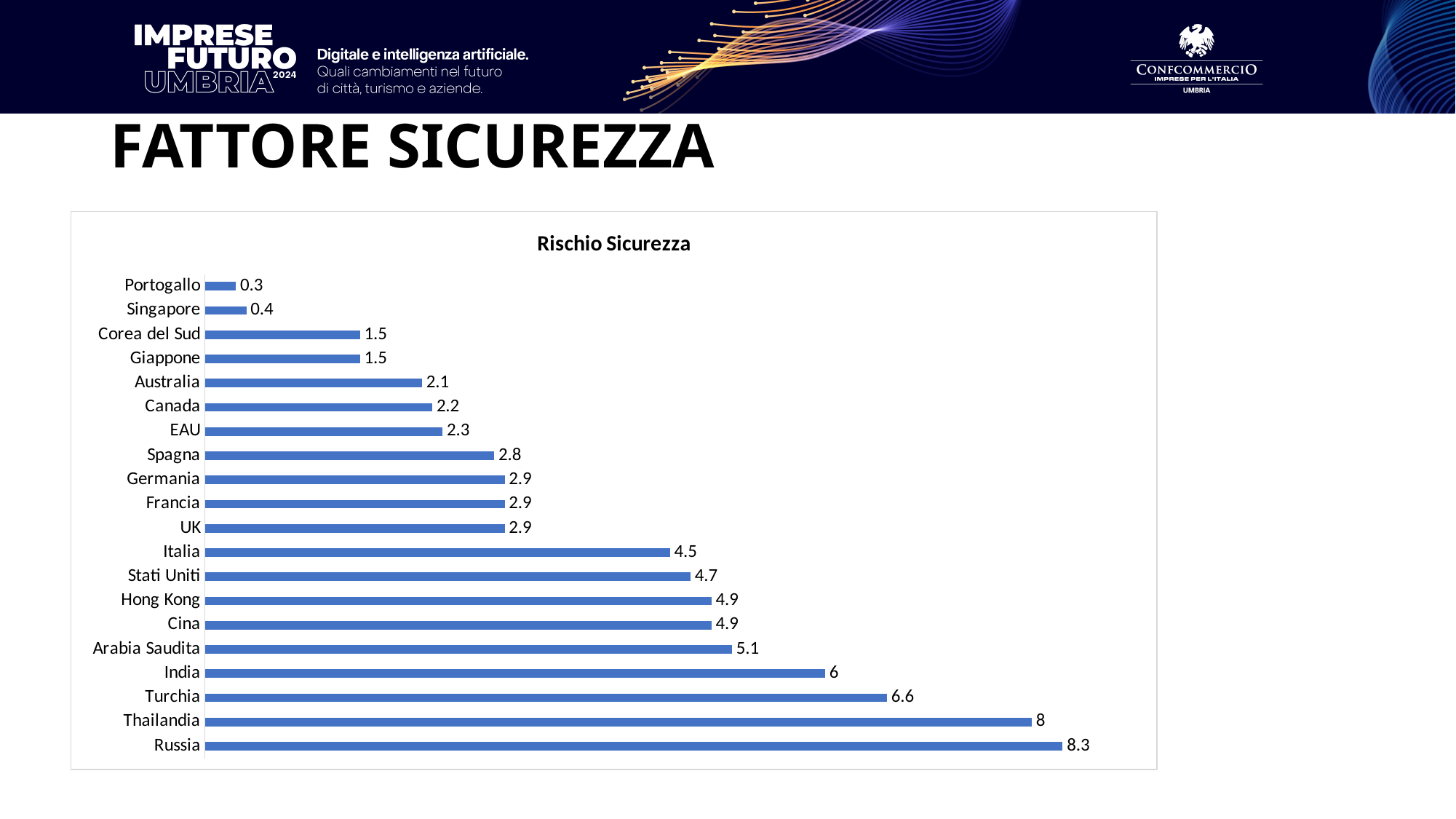
Which has a larger value, Canada or Arabia Saudita? Arabia Saudita What is the value for Portogallo in the Rischio Sicurezza chart? 0.3 What is the title of the chart on the slide? Rischio Sicurezza How many countries are shown in the Rischio Sicurezza chart? 20 Which country has the lowest value in the Rischio Sicurezza chart? Portogallo Which country has the highest value in the Rischio Sicurezza chart? Russia Which has a larger value, Stati Uniti or Spagna? Stati Uniti What kind of chart is the Rischio Sicurezza chart? Bar chart What is the value for Turchia in the Rischio Sicurezza chart? 6.6 What is the difference between the values for India and Italia? 1.5 What is the difference between the values for Russia and Thailandia? 0.3 What is the value for Italia in the Rischio Sicurezza chart? 4.5